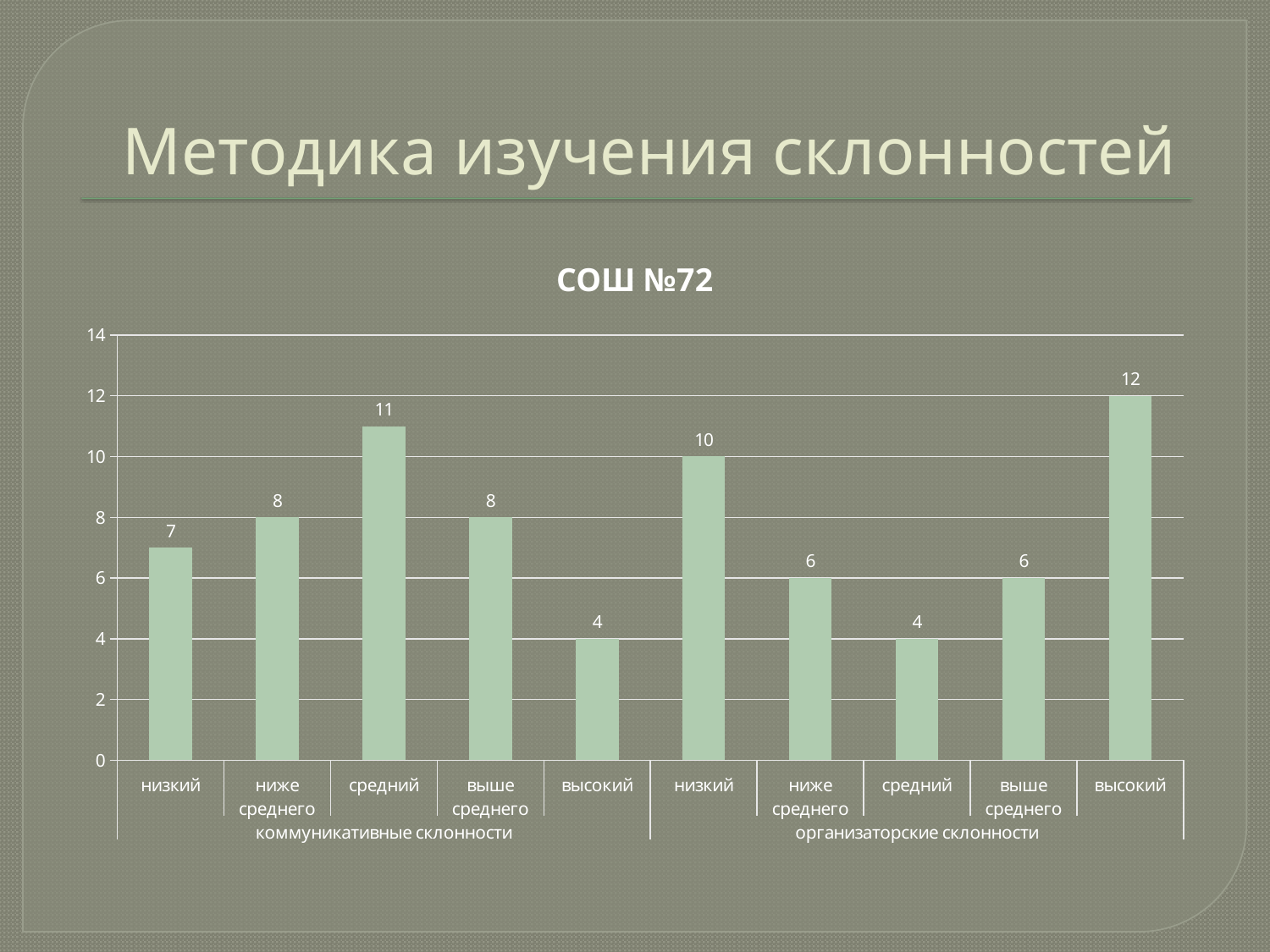
What is the difference between the 'высокий' values for 'организаторские склонности' and 'коммуникативные склонности'? 8 What is the value for the 'низкий' level under 'организаторские склонности'? 10 What type of chart is shown on the slide? bar chart Which level has the lowest value under 'коммуникативные склонности'? высокий Which is larger: the 'низкий' value for 'коммуникативные склонности' or for 'организаторские склонности'? организаторские склонности What is the total of the 'ниже среднего' values across both groups? 14 What is the value for the 'высокий' level under 'организаторские склонности'? 12 How many bars are plotted in the chart? 10 What is the value for the 'средний' level under 'коммуникативные склонности'? 11 Which category has the highest value in the chart? высокий (организаторские склонности) What is the title of the chart? СОШ №72 Is the value for 'средний' under 'организаторские склонности' greater or less than 6? less